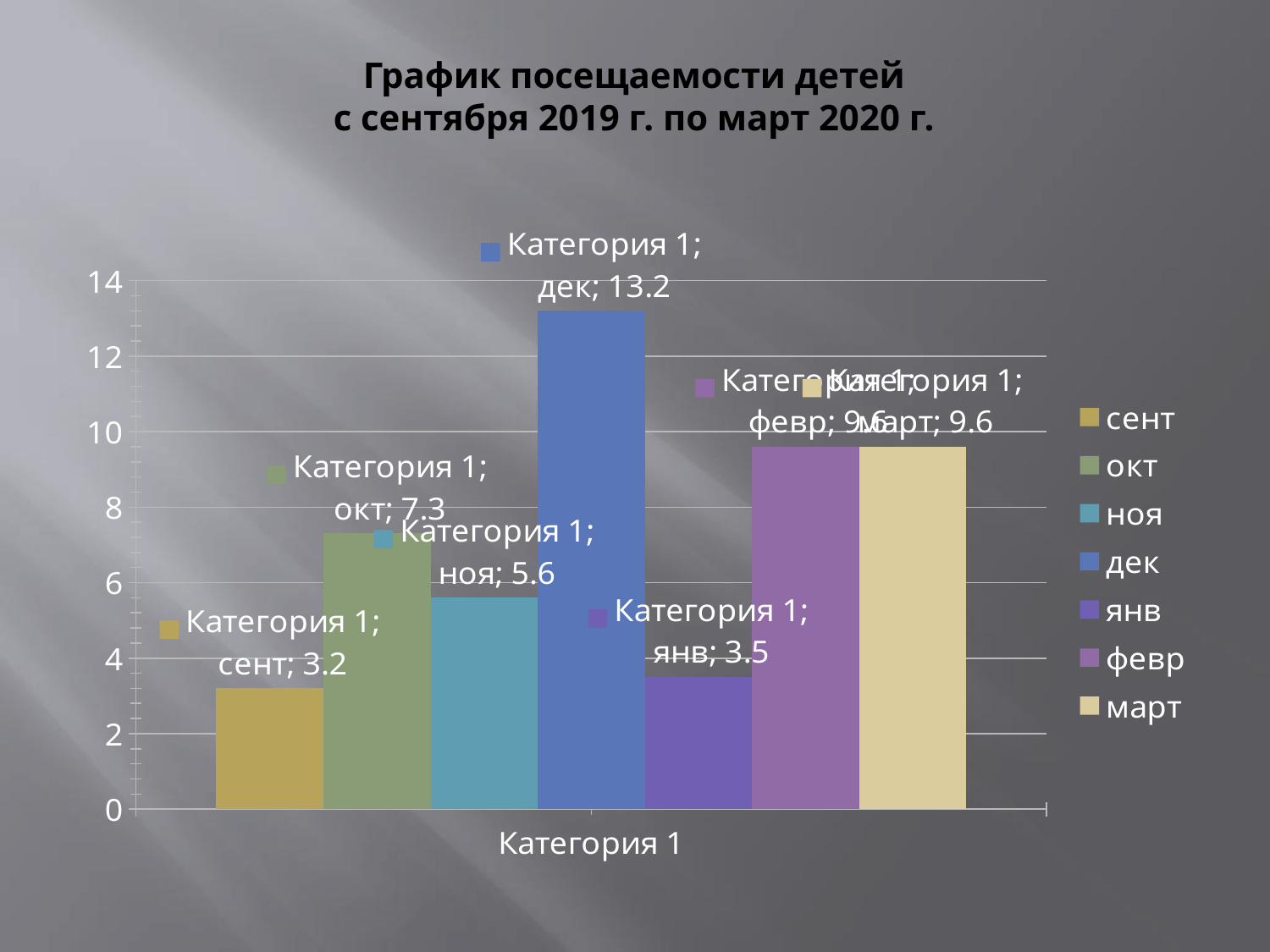
What is the difference between the values for дек and сент? 10 How many series does the legend list? 7 What is the value for март (March) in the chart? 9.6 What is the value for окт (October) in the chart? 7.3 What is the value for дек (December) in the chart? 13.2 What is the value for сент (September) in the chart? 3.2 Which month has the lowest value in the chart? сент What kind of chart is shown on the slide? bar chart What is the value for янв (January) in the chart? 3.5 Which is larger, the value for окт or the value for ноя? окт Which month has the highest value in the chart? дек Is the value for февр greater or less than 8? greater